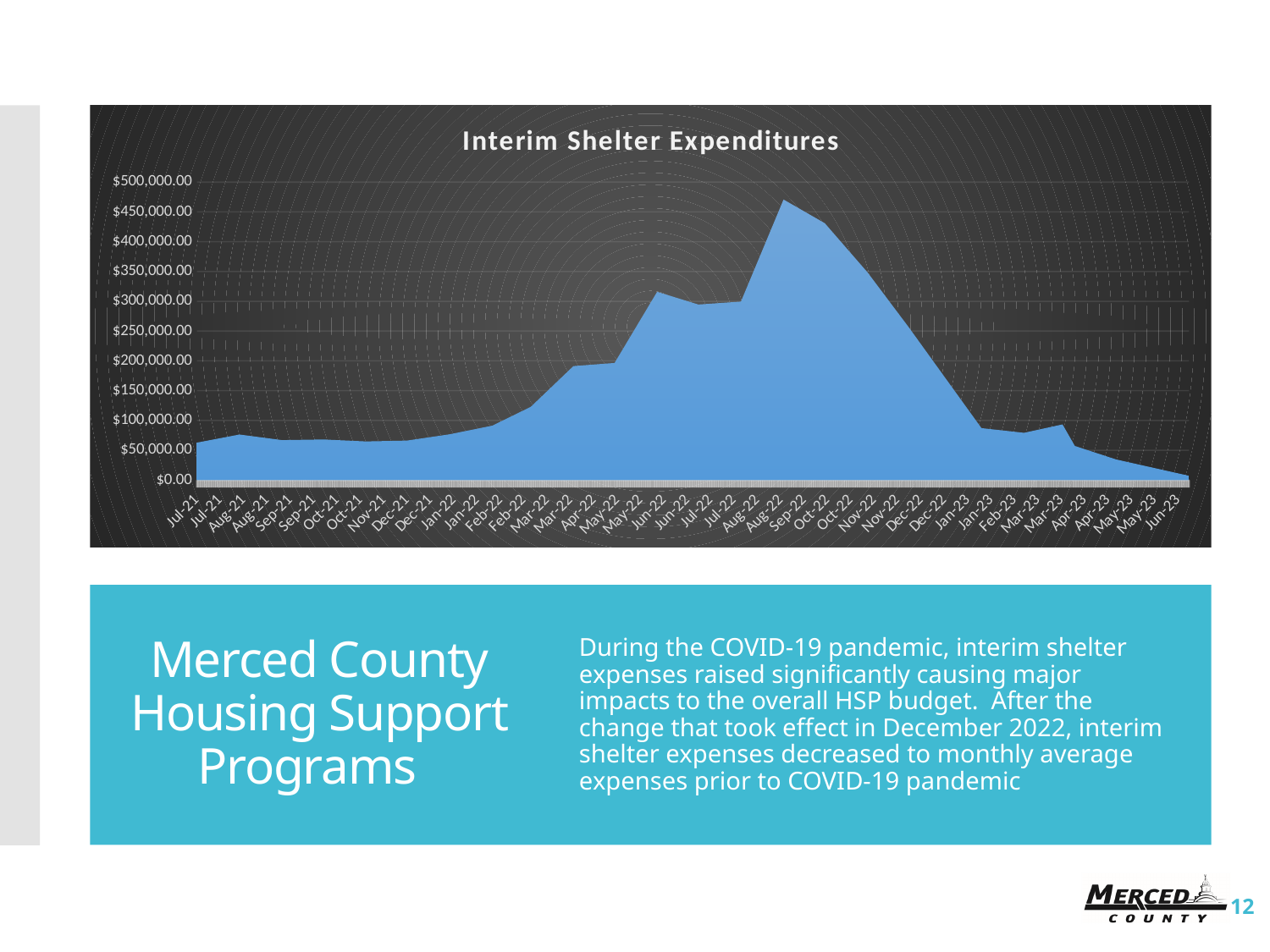
Is the value for Jun-23 in the Interim Shelter Expenditures chart greater or less than $50,000.00? less In the Interim Shelter Expenditures chart, which is larger, the value for Jun-22 or the value for Jun-23? Jun-22 In the Interim Shelter Expenditures chart, do the values rise or fall between Jan-22 and Jun-22? rise Is the peak value of the Interim Shelter Expenditures chart greater or less than $500,000.00? less What is the highest value shown on the y axis of the Interim Shelter Expenditures chart? $500,000.00 Is the value for Jun-22 in the Interim Shelter Expenditures chart greater or less than $200,000.00? greater What is the title of the chart on the slide? Interim Shelter Expenditures What kind of chart is the Interim Shelter Expenditures chart? Area chart In the Interim Shelter Expenditures chart, which is larger, the value for Sep-22 or the value for Sep-21? Sep-22 In the Interim Shelter Expenditures chart, do the values rise or fall between Sep-22 and Jan-23? fall